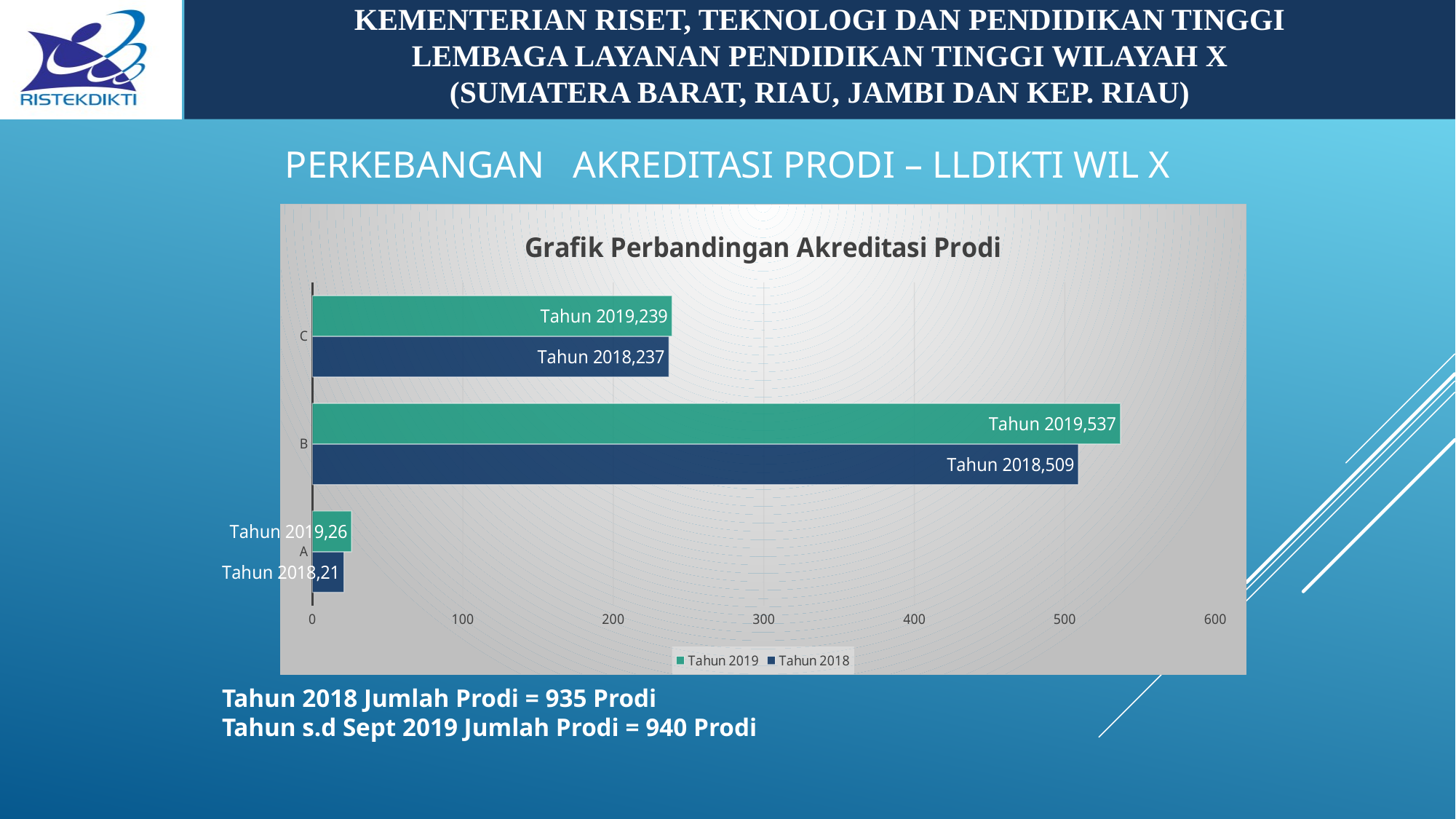
What is the title of the chart? Grafik Perbandingan Akreditasi Prodi What is the value for Tahun 2018 in category A? 21 How many series does the legend list? 2 What is the difference between the Tahun 2019 and Tahun 2018 values in category B? 28 What is the value for Tahun 2019 in category B? 537 What is the value for Tahun 2018 in category C? 237 What is the difference between the Tahun 2019 and Tahun 2018 values in category A? 5 How many categories are shown on the chart? 3 Which is larger in category C: the Tahun 2019 value or the Tahun 2018 value? Tahun 2019 Which category has the lowest value for Tahun 2018? A What kind of chart is shown on the slide? Bar chart Which category has the highest value for Tahun 2019? B